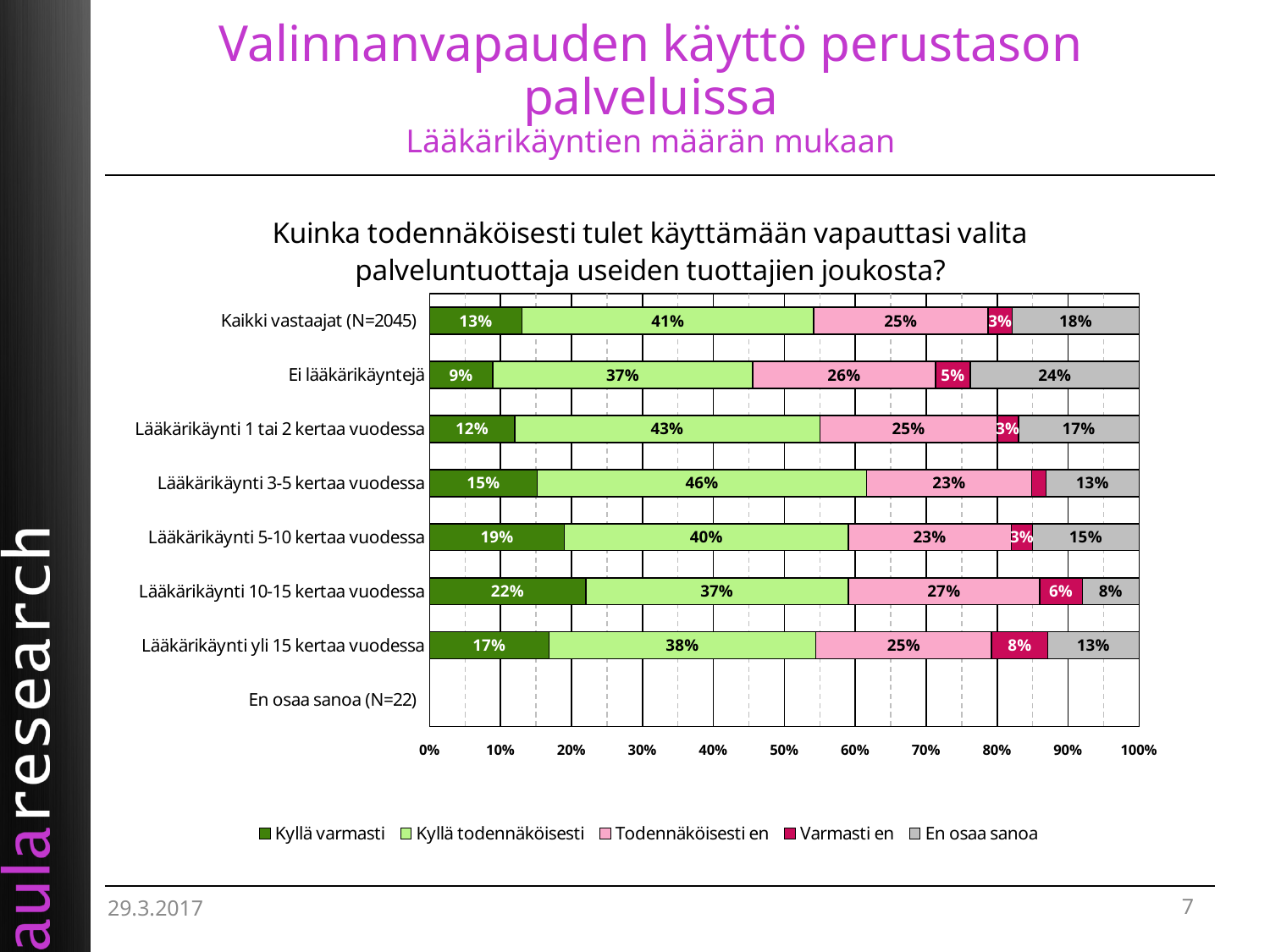
What is the title of the chart? Kuinka todennäköisesti tulet käyttämään vapauttasi valita palveluntuottaja useiden tuottajien joukosta? Which category has the lowest 'Kyllä varmasti' value? Ei lääkärikäyntejä What is the difference between the 'Kyllä todennäköisesti' values for 'Lääkärikäynti 1 tai 2 kertaa vuodessa' and 'Ei lääkärikäyntejä'? 6% What is the 'En osaa sanoa' value for 'Ei lääkärikäyntejä'? 24% What is the 'Kyllä todennäköisesti' value for 'Lääkärikäynti 3-5 kertaa vuodessa'? 46% Which category has the highest 'Kyllä varmasti' value? Lääkärikäynti 10-15 kertaa vuodessa How many category labels are listed on the vertical axis of the chart? 8 What is the 'Kyllä varmasti' value for 'Kaikki vastaajat (N=2045)'? 13% What is the 'Varmasti en' value for 'Lääkärikäynti yli 15 kertaa vuodessa'? 8% How many series does the legend list? 5 What kind of chart is shown on the slide? Stacked bar chart Which is larger: the 'Todennäköisesti en' value for 'Lääkärikäynti 10-15 kertaa vuodessa' or for 'Lääkärikäynti 5-10 kertaa vuodessa'? Lääkärikäynti 10-15 kertaa vuodessa